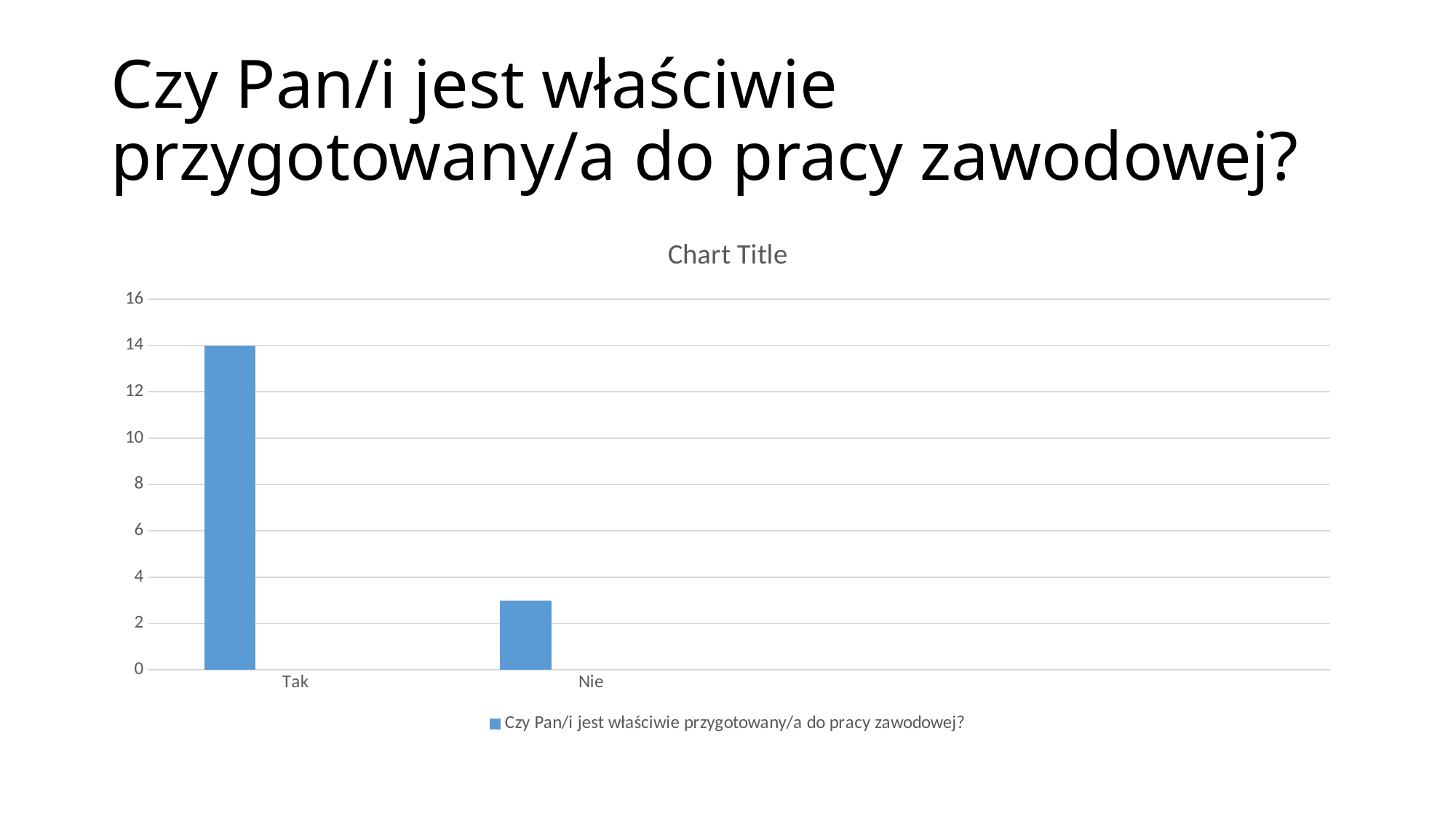
Which is larger, the value for Tak or the value for Nie? Tak Which category has the lowest value? Nie How many categories are shown on the x axis? 2 Which category has the highest value? Tak How many series does the legend list? 1 Is the value for Nie greater or less than 2? greater What is the title shown above the chart? Chart Title What kind of chart is shown? bar chart What is the value for Tak? 14 Is the value for Tak greater or less than 10? greater What is the highest value shown on the vertical axis? 16 Is the value for Nie greater or less than 4? less